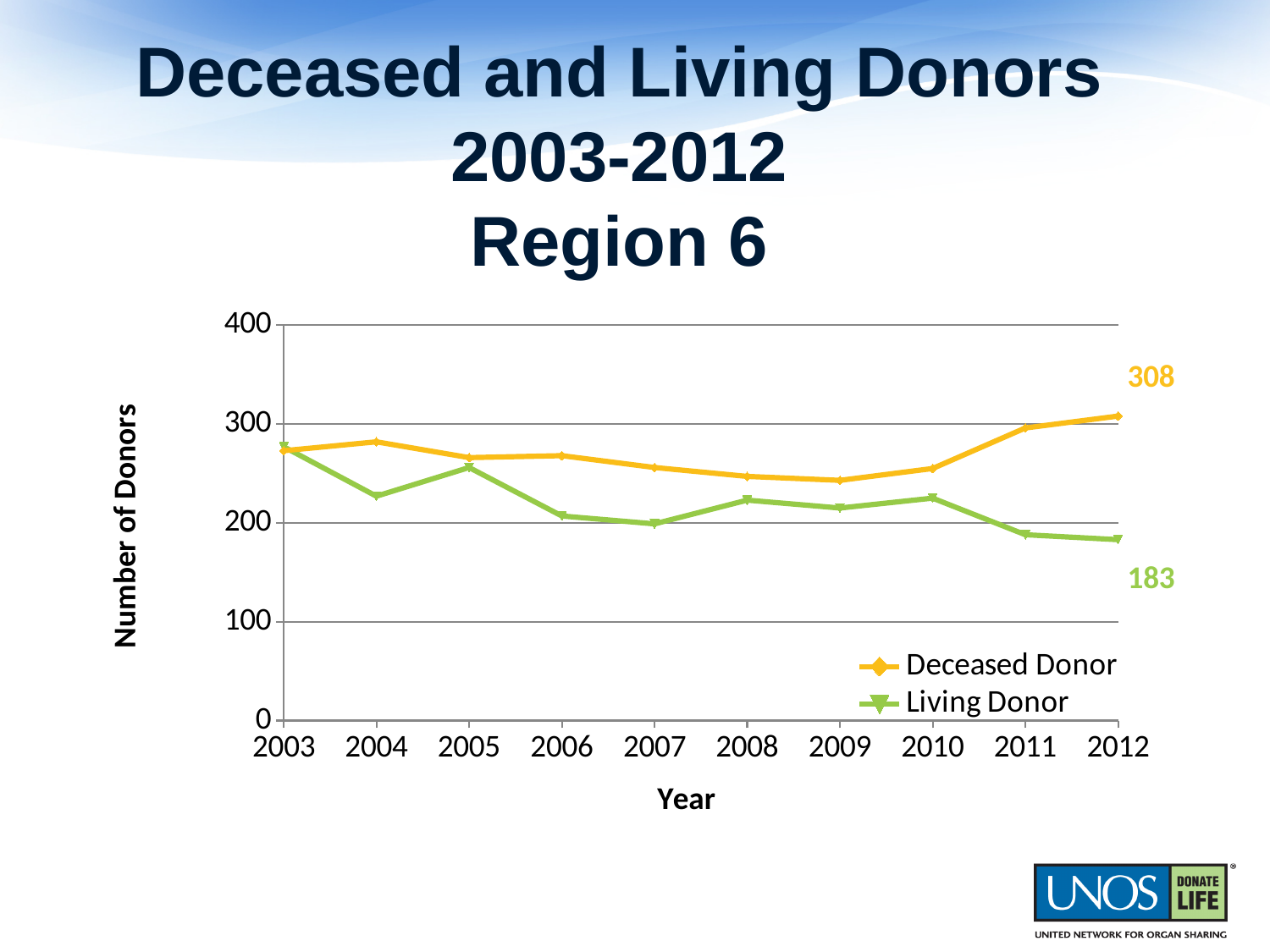
What is the value for Deceased Donor in 2012? 308 In 2012, which series has the larger value, Deceased Donor or Living Donor? Deceased Donor Does the Deceased Donor series rise or fall from 2009 to 2012? rise What is the difference between the Deceased Donor and Living Donor values in 2012? 125 In which year is the Deceased Donor value highest? 2012 How many series does the legend list? 2 Is the value for Living Donor in 2007 greater or less than 250? less Is the value for Deceased Donor in 2011 greater or less than 250? greater Is the value for Living Donor in 2004 greater or less than 250? less What is the value for Living Donor in 2012? 183 How many years are shown on the x axis? 10 What kind of chart is shown on the slide? line chart